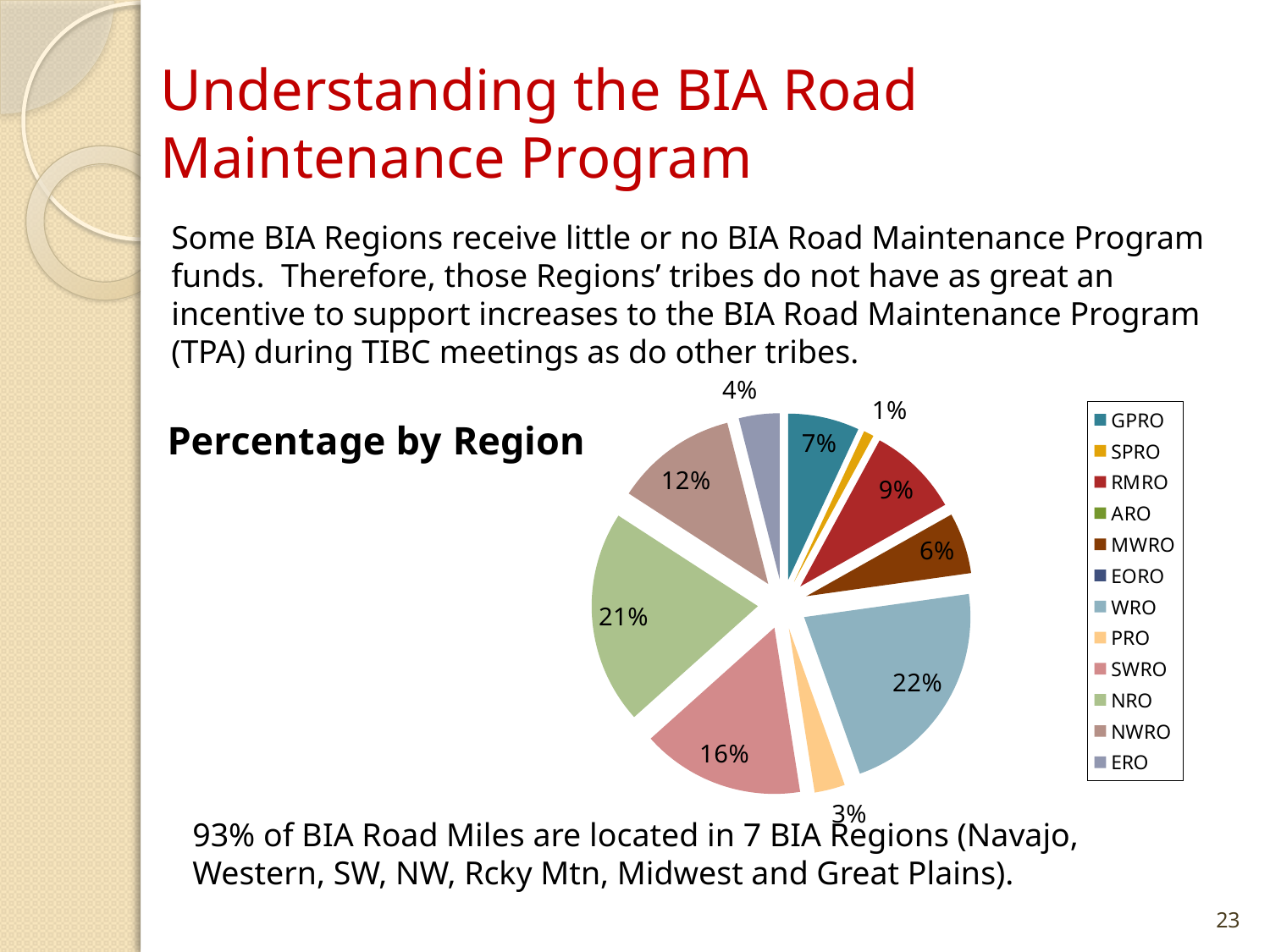
What is the difference between the WRO and SWRO percentages? 6% What percentage does GPRO represent? 7% Which slice is larger, NRO or NWRO? NRO What is the value shown for the PRO slice? 3% What percentage does NWRO account for in the pie chart? 12% How many regions are listed in the chart's legend? 12 Which region has the largest slice in the pie chart? WRO What type of chart is used to show the percentage by region? Pie chart What percentage is labelled on the RMRO slice? 9% What is the value of the SWRO slice? 16% What percentage does the WRO slice represent in the Percentage by Region pie chart? 22% What percentage is shown for NRO in the pie chart? 21%